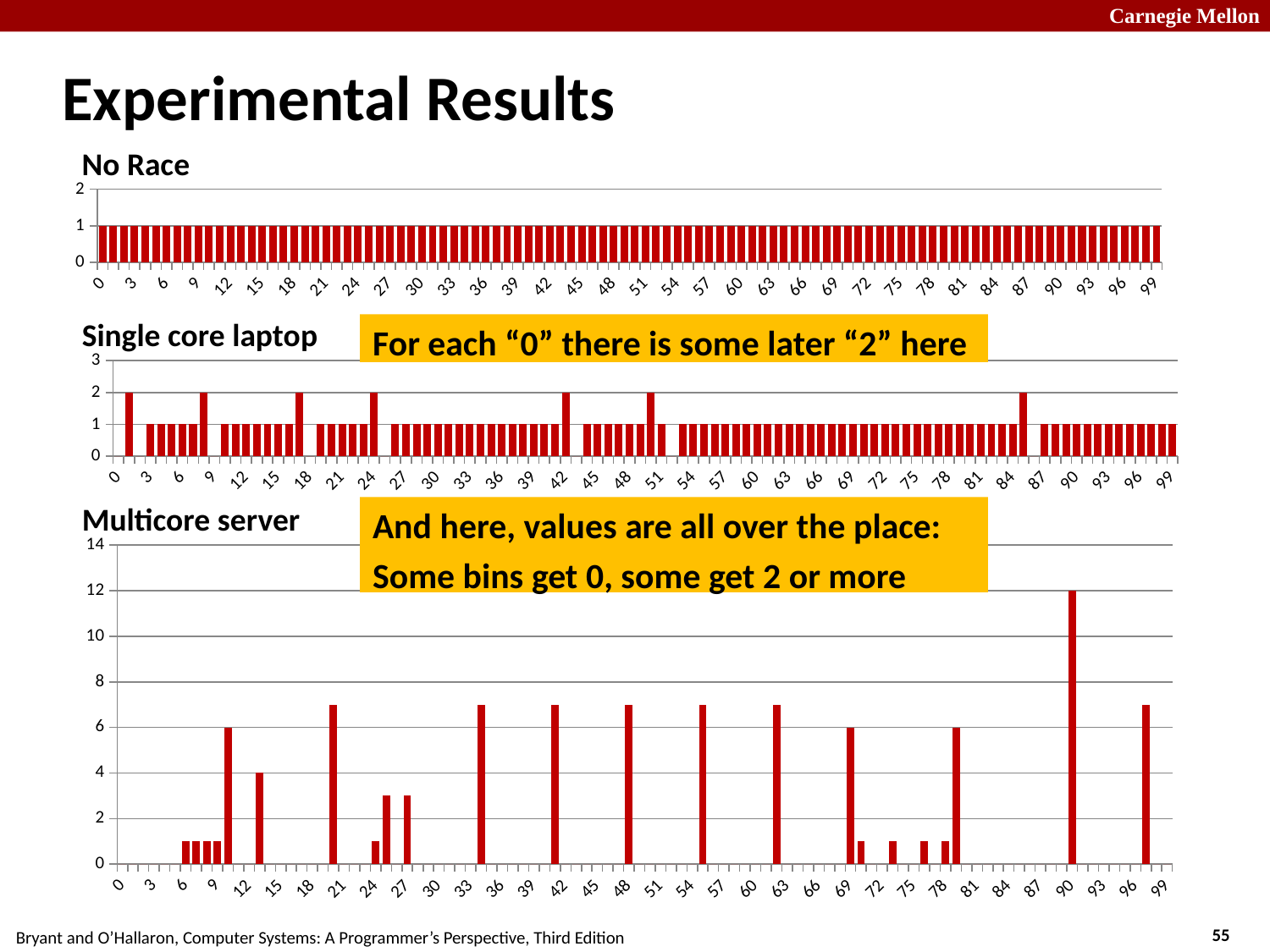
In the "No Race" chart, what is the value plotted for category 50? 1 How many charts are shown on the slide? 3 In the "Single core laptop" chart, what is the highest value any bar reaches? 2 In the "Multicore server" chart, what is the value of the tallest bar? 12 Which chart has the taller maximum bar, "Single core laptop" or "Multicore server"? Multicore server In the "No Race" chart, do the values rise, fall, or stay constant across the x axis? stay constant In the "Multicore server" chart, is the tallest bar greater or less than 10? greater In the "Multicore server" chart, which category has the tallest bar? 90 In the "Multicore server" chart, what is the value plotted for category 0? 0 In the "Single core laptop" chart, what is the lowest value plotted? 0 What kind of chart is the "No Race" chart at the top of the slide? bar chart